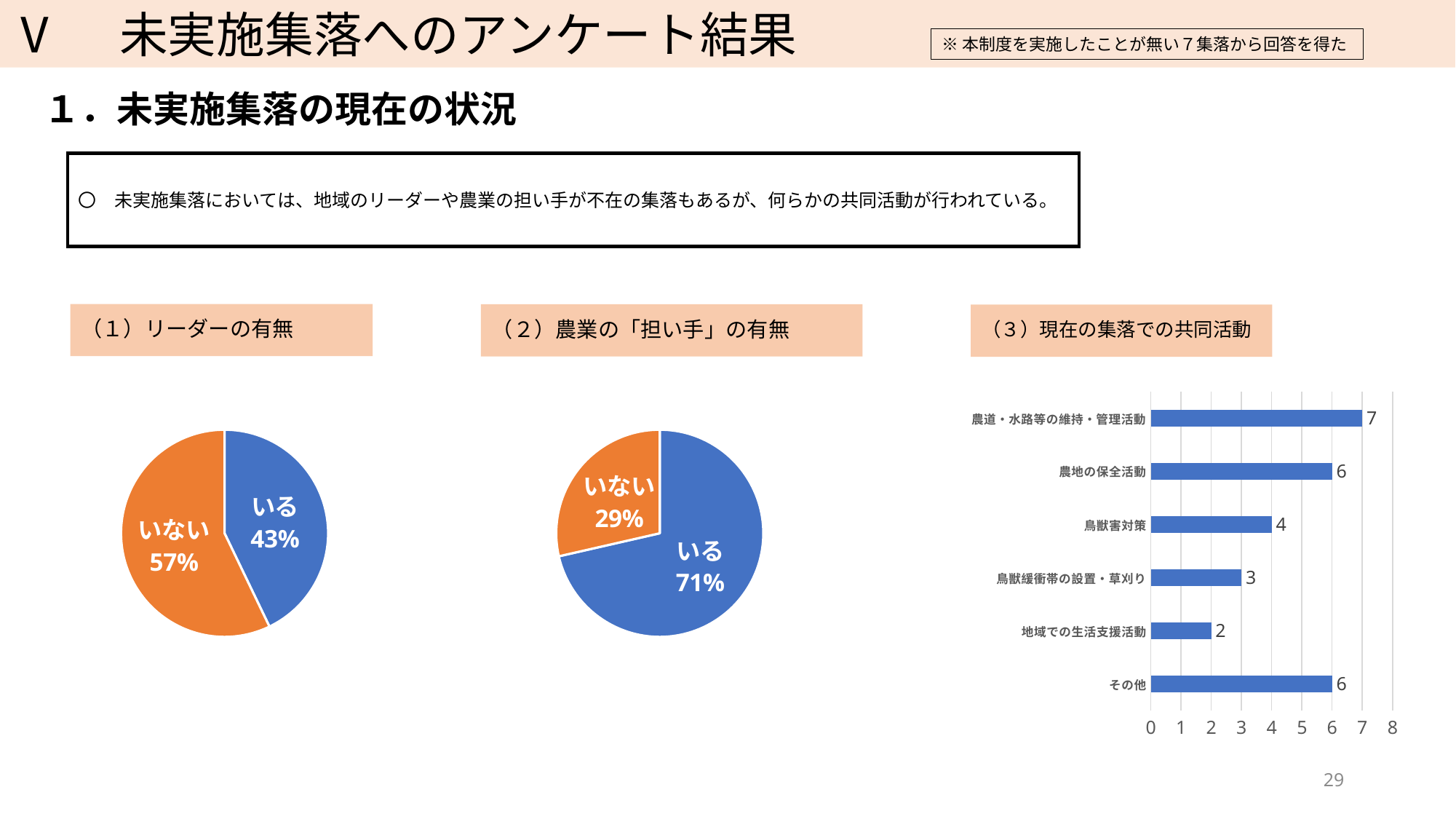
What kind of chart is the (3) 現在の集落での共同活動 chart? bar chart In the (3) 現在の集落での共同活動 chart, which category has the lowest value? 地域での生活支援活動 In the (2) 農業の「担い手」の有無 pie chart, what share is labelled いない? 29% In the (1) リーダーの有無 pie chart, what share is labelled いない? 57% In the (3) 現在の集落での共同活動 chart, what is the value for 農道・水路等の維持・管理活動? 7 In the (2) 農業の「担い手」の有無 pie chart, what is the difference between the いる and いない shares? 42% In the (3) 現在の集落での共同活動 chart, what is the difference between 農地の保全活動 and 鳥獣緩衝帯の設置・草刈り? 3 In the (2) 農業の「担い手」の有無 pie chart, what share is labelled いる? 71% In the (3) 現在の集落での共同活動 chart, what is the value for 鳥獣害対策? 4 In the (3) 現在の集落での共同活動 chart, how many categories are shown? 6 In the (1) リーダーの有無 pie chart, which slice is larger, いる or いない? いない